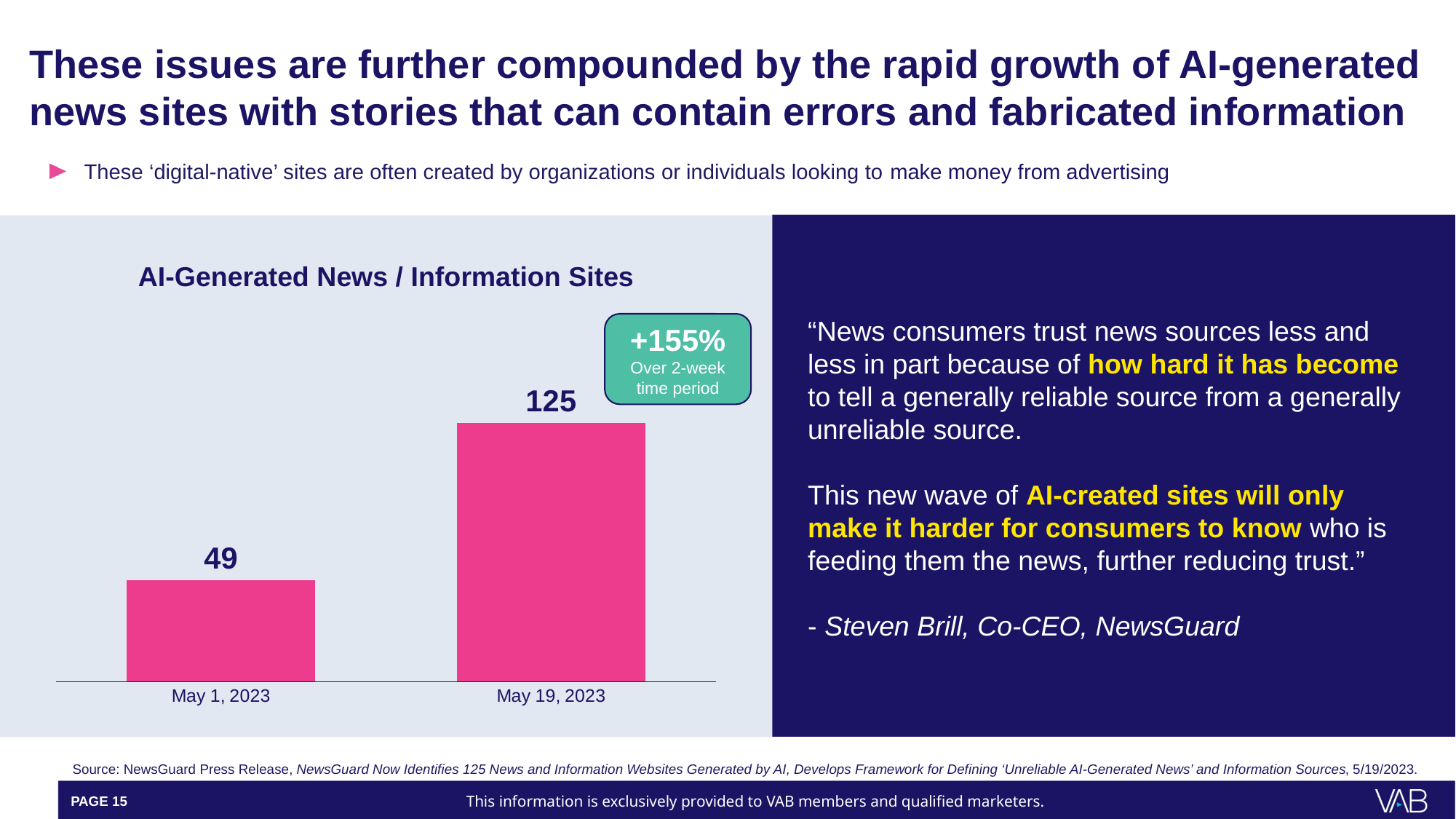
What is the value for May 1, 2023? 49 What is the title of the chart? AI-Generated News / Information Sites What kind of chart is shown on the slide? Bar chart What is the difference between the values for May 19, 2023 and May 1, 2023? 76 How many categories are shown in the chart? 2 Which date has the highest value? May 19, 2023 Do the values rise or fall from May 1, 2023 to May 19, 2023? Rise What is the value for May 19, 2023? 125 Which is larger, the value for May 1, 2023 or May 19, 2023? May 19, 2023 What percentage change is shown in the callout box on the chart? +155% Which date has the lowest value? May 1, 2023